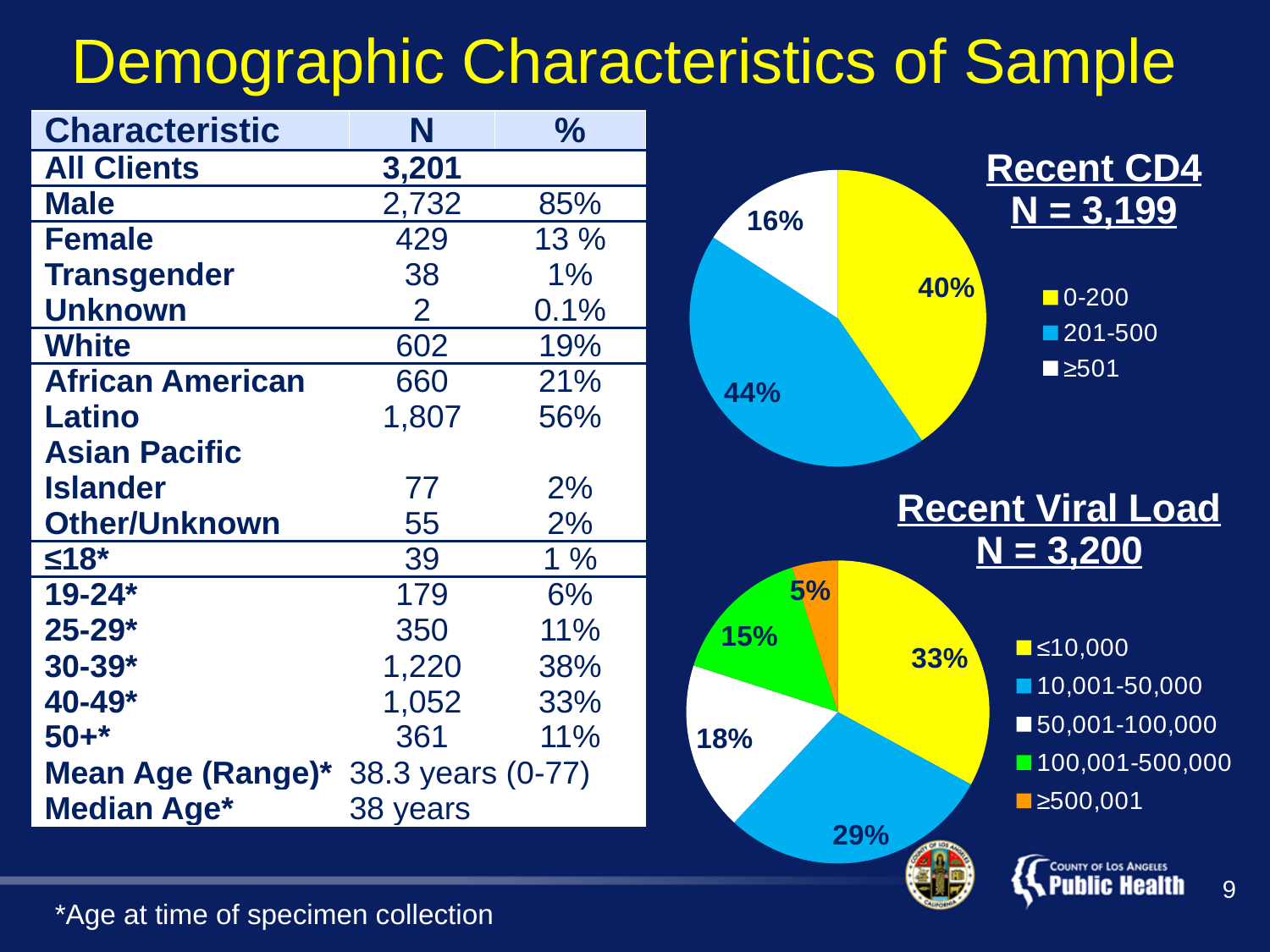
In the Recent Viral Load pie chart, what share of the sample has a viral load of 100,001-500,000? 15% In the Recent Viral Load pie chart, which is larger: the 10,001-50,000 slice or the 50,001-100,000 slice? 10,001-50,000 In the Recent CD4 pie chart, which CD4 category has the largest share? 201-500 What type of chart is used to show Recent Viral Load? Pie chart In the Recent CD4 pie chart, what share of the sample has a CD4 count of 201-500? 44% In the Recent CD4 pie chart, which CD4 category has the smallest share? ≥501 In the Recent Viral Load pie chart, which viral load category has the smallest share? ≥500,001 How many categories does the legend of the Recent Viral Load chart list? 5 In the Recent CD4 pie chart, what is the difference in percentage points between the 201-500 slice and the 0-200 slice? 4 In the Recent CD4 pie chart, what share of the sample has a CD4 count of ≥501? 16% How many categories does the legend of the Recent CD4 chart list? 3 In the Recent Viral Load pie chart, what share of the sample has a viral load of ≤10,000? 33%